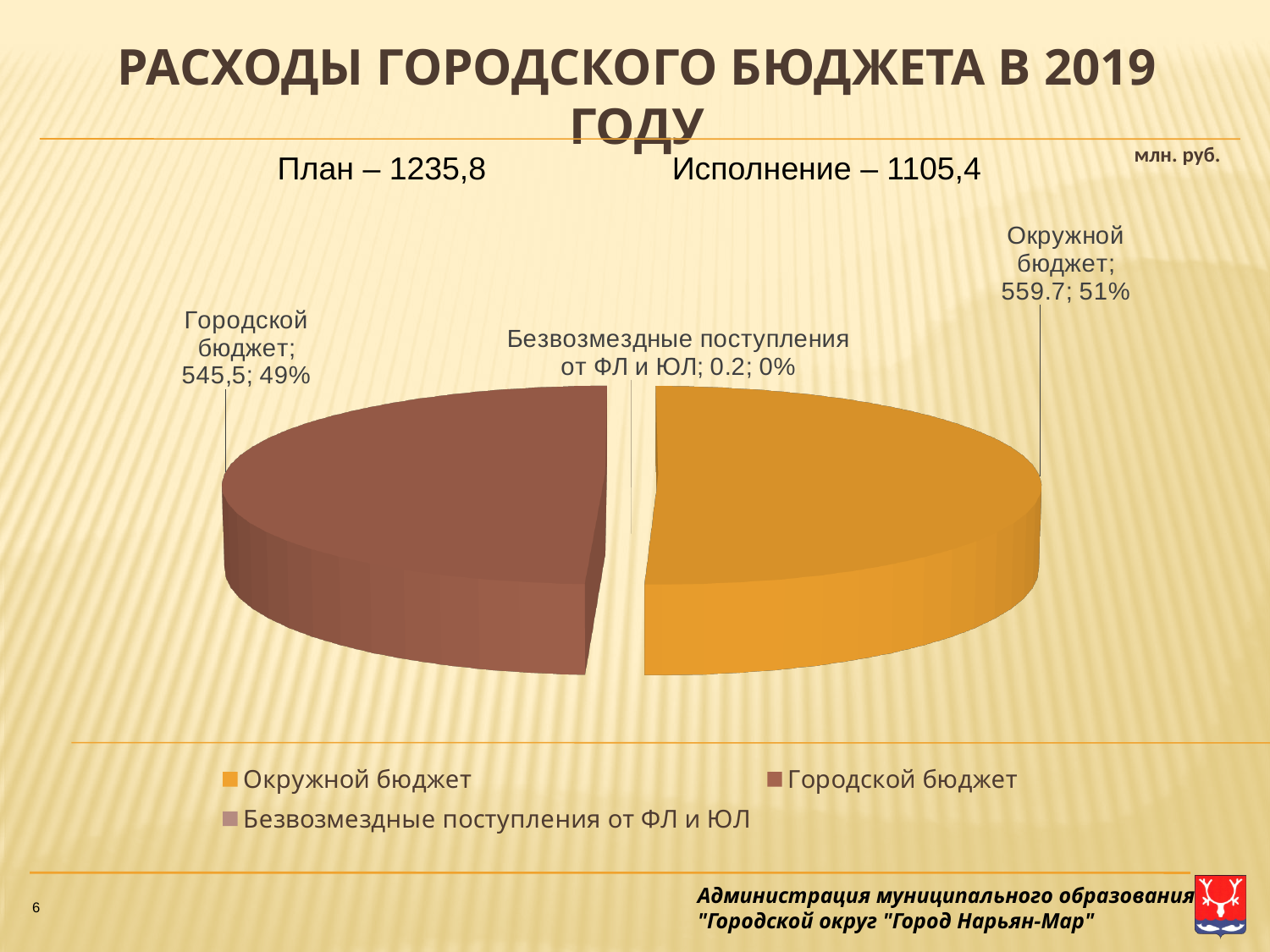
What is the value for Безвозмездные поступления от ФЛ и ЮЛ? 0.2 Which is larger, Окружной бюджет or Городской бюджет? Окружной бюджет What kind of chart is shown on the slide? pie chart What is the value for Городской бюджет? 545,5 What share of the pie does Городской бюджет take? 49% What is the value for Окружной бюджет? 559.7 What is the title of the slide? РАСХОДЫ ГОРОДСКОГО БЮДЖЕТА В 2019 ГОДУ What is the difference between the values for Окружной бюджет and Городской бюджет? 14.2 How many slices does the pie chart have? 3 What share of the pie does Окружной бюджет take? 51% Which slice is the smallest? Безвозмездные поступления от ФЛ и ЮЛ Which slice is the largest? Окружной бюджет